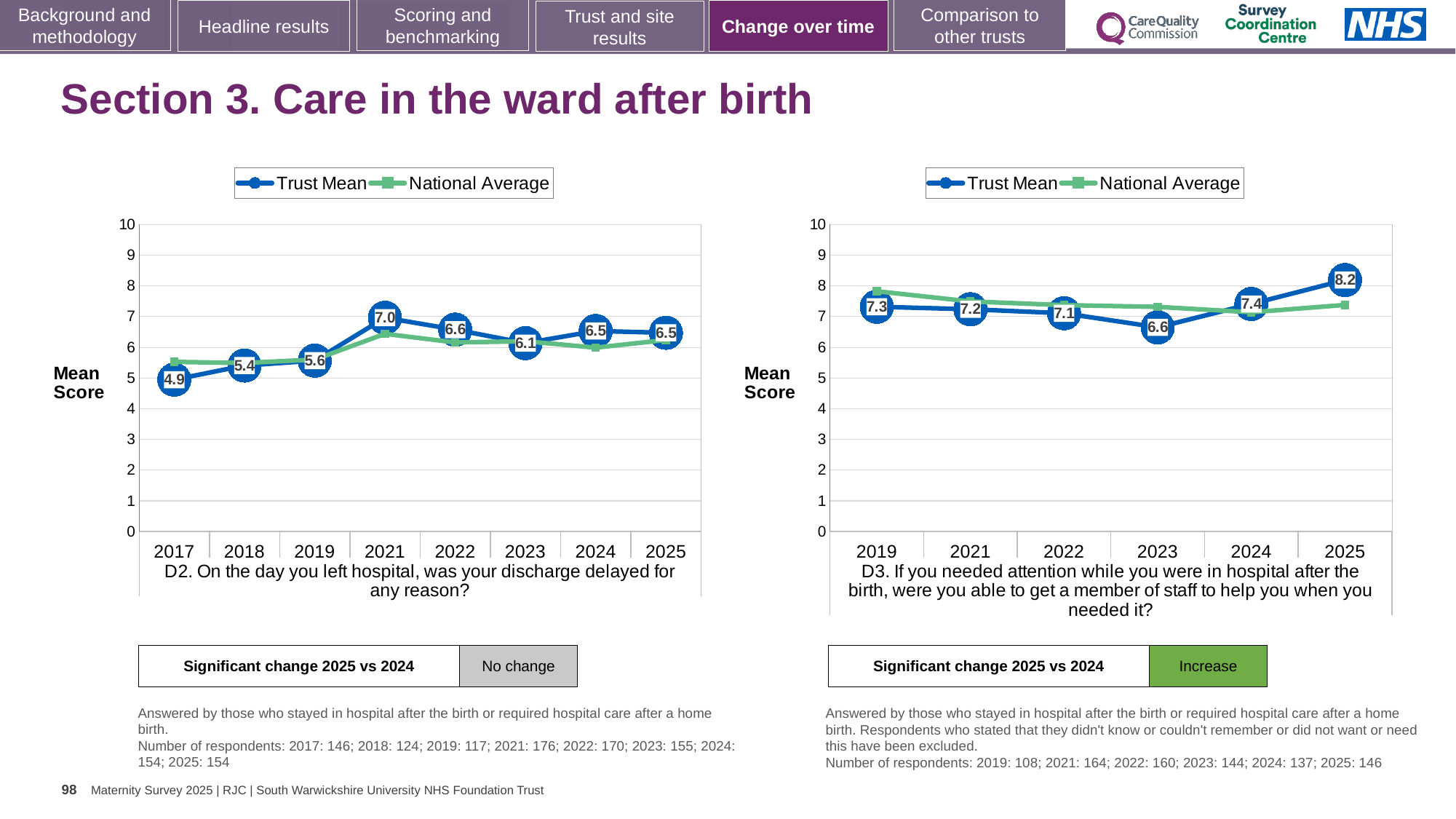
In the D3 chart (right), how many series does the legend list? 2 In the D2 chart (left), what is the Trust Mean score for 2021? 7.0 In the D3 chart (right), what is the difference between the Trust Mean scores for 2025 and 2024? 0.8 In the D2 chart (left), what is the difference between the Trust Mean scores for 2021 and 2017? 2.1 In the D3 chart (right), is the Trust Mean score for 2025 greater or less than 8? greater In the D2 chart (left), how many years are plotted on the x axis? 8 In the D2 chart (left), which year has the lowest Trust Mean score? 2017 In the D3 chart (right), what is the Trust Mean score for 2025? 8.2 What kind of chart is the D3 chart (right)? Line chart In the D2 chart (left), which year has the highest Trust Mean score? 2021 In the D2 chart (left), what is the Trust Mean score for 2017? 4.9 In the D3 chart (right), which year has the lowest Trust Mean score? 2023